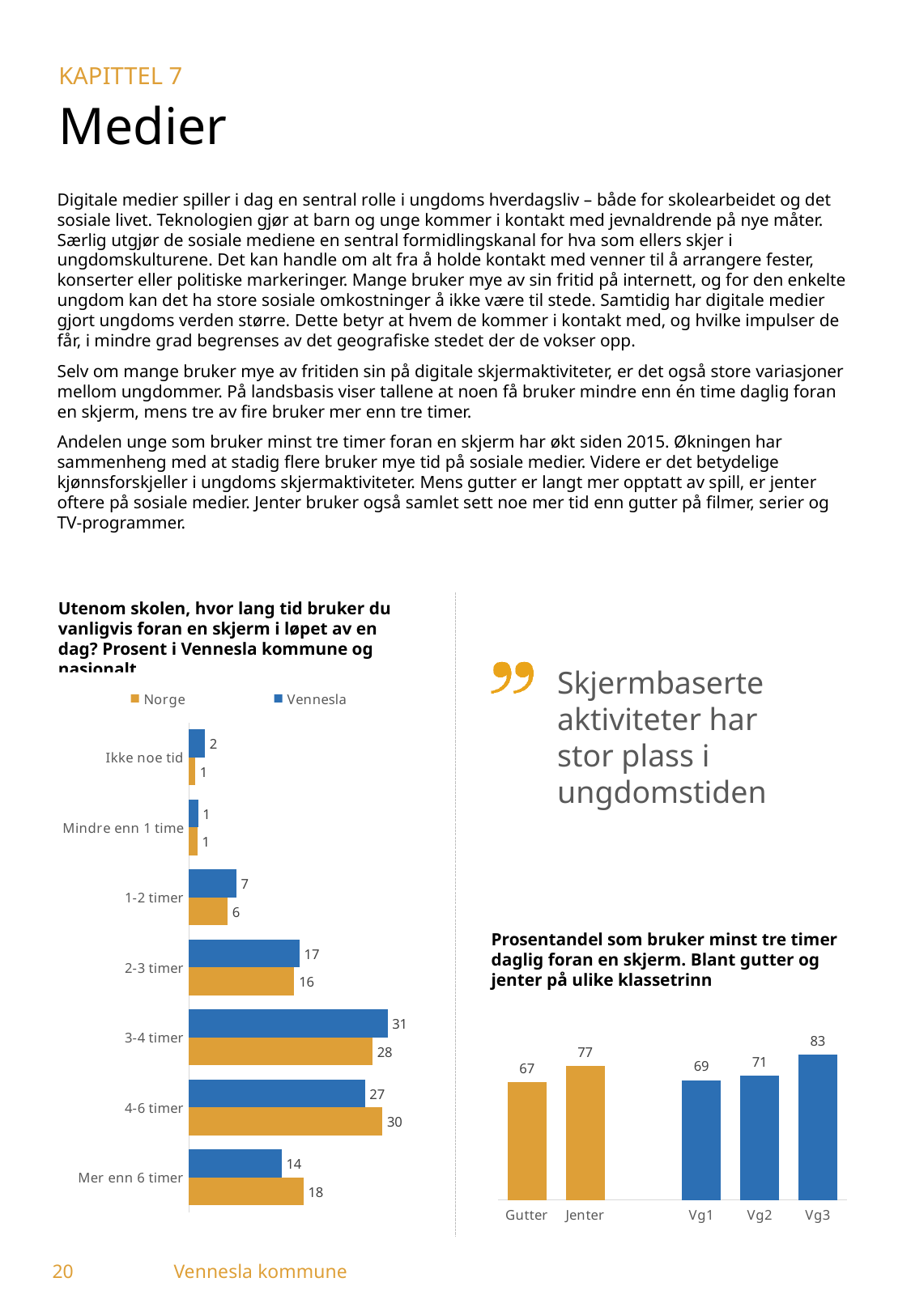
In the left chart (Utenom skolen, hvor lang tid bruker du vanligvis foran en skjerm), what is the difference between the Norge and Vennesla values for 4-6 timer? 3 In the right chart (Prosentandel som bruker minst tre timer daglig foran en skjerm), what is the value for Jenter? 77 What kind of chart is the left chart (Utenom skolen, hvor lang tid bruker du vanligvis foran en skjerm)? Bar chart In the right chart (Prosentandel som bruker minst tre timer daglig foran en skjerm), do the values rise or fall from Vg1 to Vg3? Rise In the right chart (Prosentandel som bruker minst tre timer daglig foran en skjerm), which category has the highest value? Vg3 In the right chart (Prosentandel som bruker minst tre timer daglig foran en skjerm), what is the difference between Jenter and Gutter? 10 In the left chart (Utenom skolen, hvor lang tid bruker du vanligvis foran en skjerm), which category has the highest Vennesla value? 3-4 timer In the left chart (Utenom skolen, hvor lang tid bruker du vanligvis foran en skjerm), how many categories are shown? 7 In the left chart (Utenom skolen, hvor lang tid bruker du vanligvis foran en skjerm), which is larger for 2-3 timer: Norge or Vennesla? Vennesla In the left chart (Utenom skolen, hvor lang tid bruker du vanligvis foran en skjerm), what is the Vennesla value for 3-4 timer? 31 In the left chart (Utenom skolen, hvor lang tid bruker du vanligvis foran en skjerm), how many series does the legend list? 2 In the left chart (Utenom skolen, hvor lang tid bruker du vanligvis foran en skjerm), what is the Norge value for Mer enn 6 timer? 18